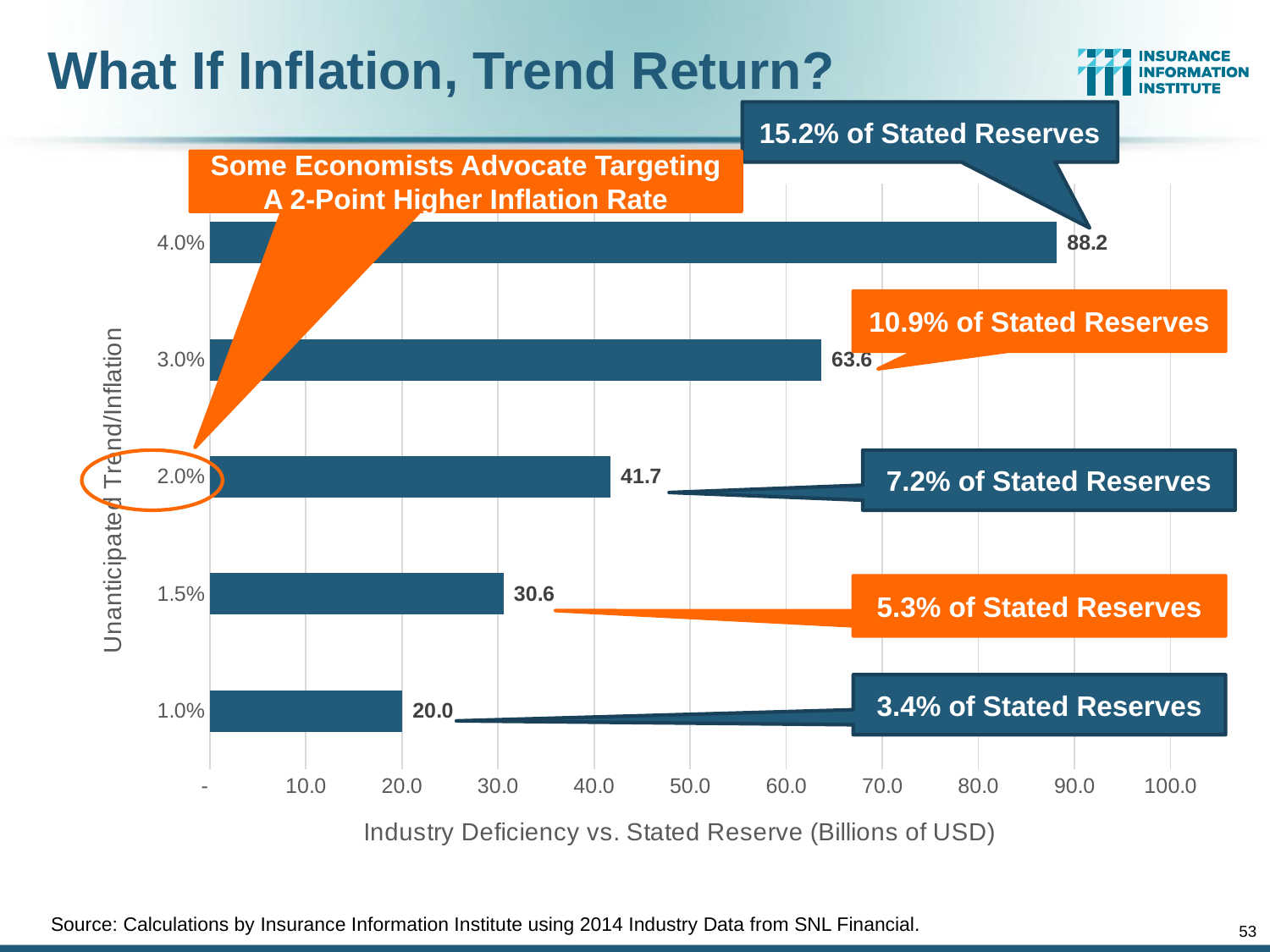
What is the industry deficiency value for an unanticipated trend/inflation of 4.0%? 88.2 How many unanticipated trend/inflation categories are shown in the chart? 5 What kind of chart is shown on the slide? Bar chart Which is larger, the industry deficiency at 1.5% or at 3.0% unanticipated trend/inflation? 3.0% What is the difference between the industry deficiency at 3.0% and at 2.0% unanticipated trend/inflation? 21.9 What is the industry deficiency value for an unanticipated trend/inflation of 1.5%? 30.6 What is the industry deficiency value for an unanticipated trend/inflation of 2.0%? 41.7 Which unanticipated trend/inflation category has the lowest industry deficiency? 1.0% What is the difference between the industry deficiency at 4.0% and at 1.0% unanticipated trend/inflation? 68.2 Is the industry deficiency at 3.0% unanticipated trend/inflation greater or less than 60.0? greater Which unanticipated trend/inflation category has the highest industry deficiency? 4.0% What is the label of the horizontal axis of the chart? Industry Deficiency vs. Stated Reserve (Billions of USD)